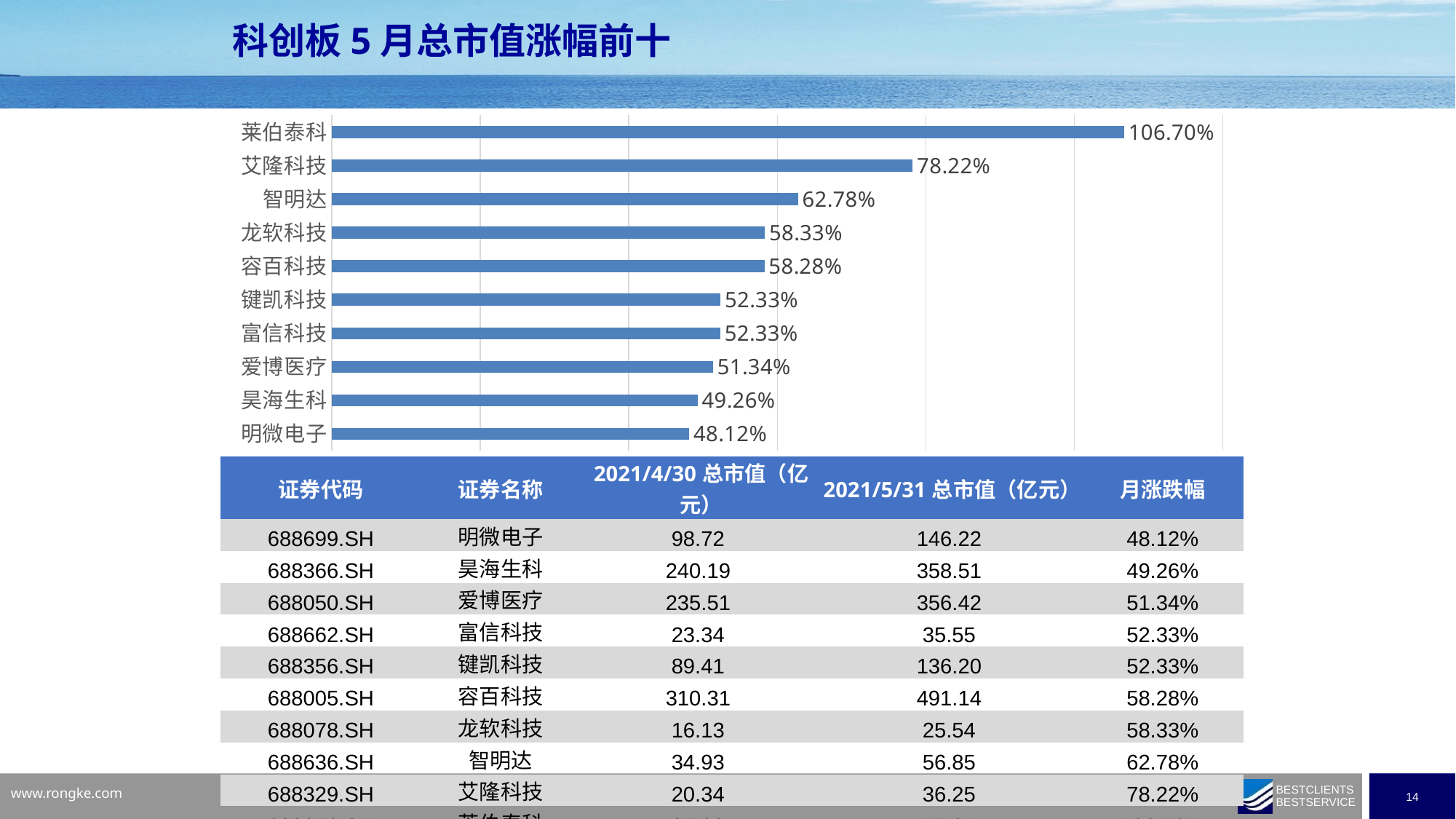
What is the difference between the values for 莱伯泰科 and 艾隆科技? 28.48% Which is larger, the value for 艾隆科技 or the value for 智明达? 艾隆科技 What is the value for 明微电子 in the chart? 48.12% Which category has the lowest value in the chart? 明微电子 What is the difference between the values for 智明达 and 明微电子? 14.66% What kind of chart is shown on the slide? Bar chart What is the title of the slide containing the chart? 科创板 5 月总市值涨幅前十 Which category has the highest value in the chart? 莱伯泰科 What is the value for 智明达 in the chart? 62.78% What is the value for 莱伯泰科 in the chart? 106.70% What is the value for 爱博医疗 in the chart? 51.34% How many categories are shown in the chart? 10